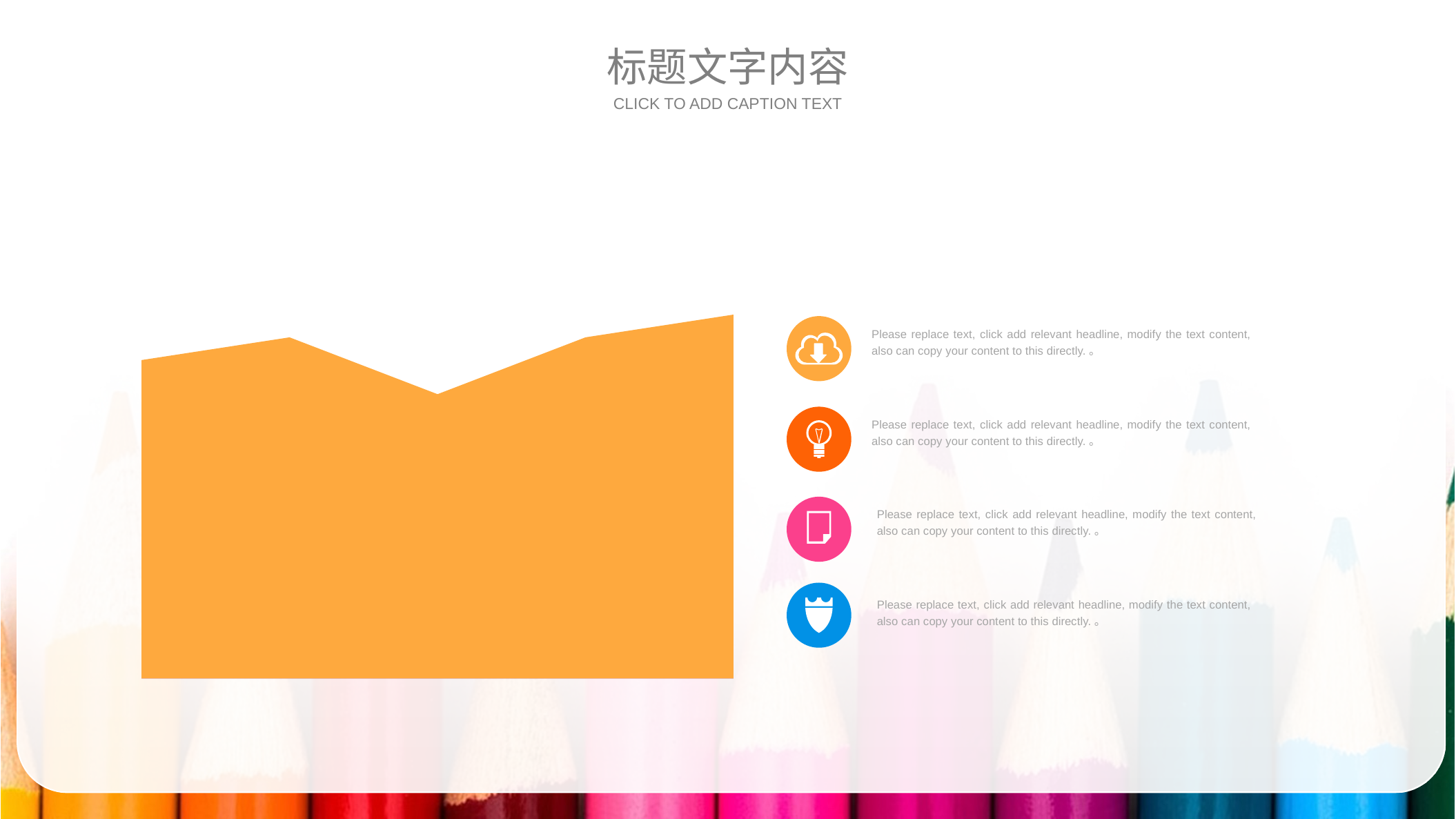
Does the area chart show a legend? No What colour is the filled area in the chart? orange What kind of chart is shown on the left of the slide? area chart Is the last point of the area chart higher or lower than the first point? higher How many data points does the area chart's outline have? 5